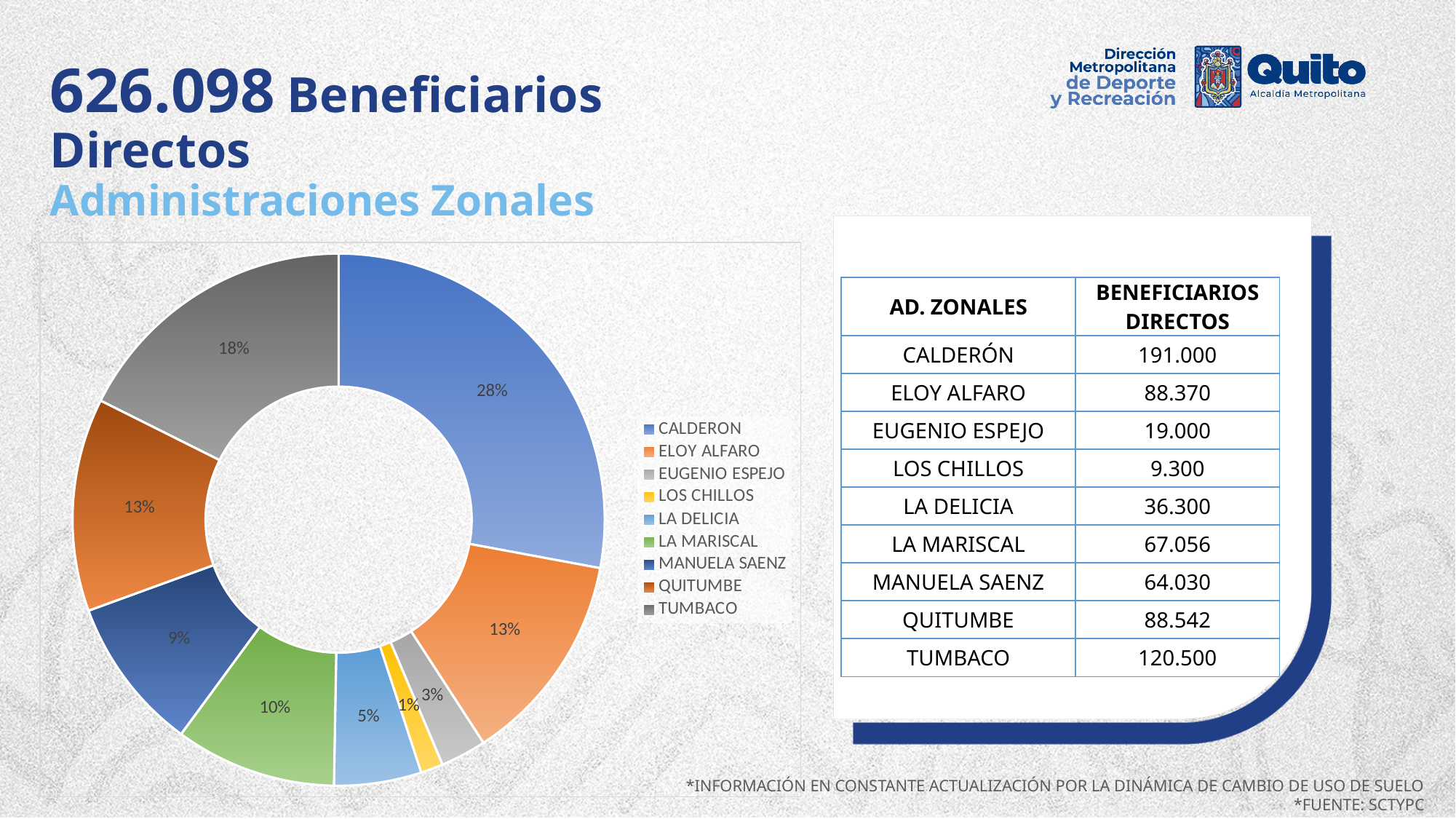
Which has a larger share in the doughnut chart, LA MARISCAL or LA DELICIA? LA MARISCAL What colour represents QUITUMBE in the doughnut chart? Dark orange What percentage share does TUMBACO have in the doughnut chart? 18% What percentage share does MANUELA SAENZ have in the doughnut chart? 9% Which administración zonal has the smallest share in the doughnut chart? LOS CHILLOS What is the difference in percentage points between the shares of CALDERON and TUMBACO? 10 What percentage share does LA MARISCAL have in the doughnut chart? 10% Which administración zonal has the largest share in the doughnut chart? CALDERON How many categories does the doughnut chart legend list? 9 What kind of chart is shown on the slide? Doughnut chart